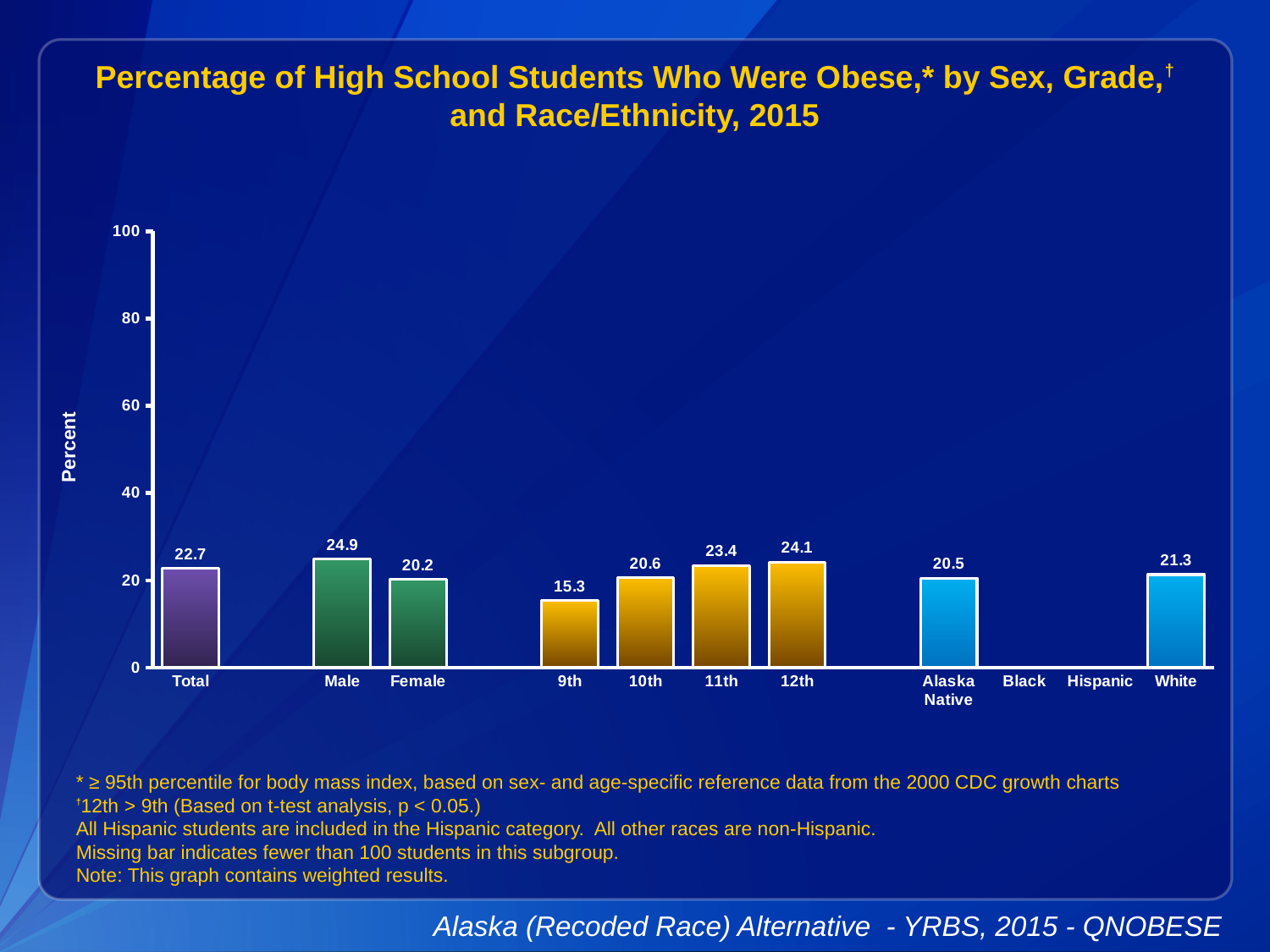
What is the difference between the values for 12th and 9th grade? 8.8 Which category has the lowest value among the bars shown? 9th What is the value for Total? 22.7 What is the value for Male? 24.9 Which is larger, the value for 11th grade or the value for 10th grade? 11th Which race/ethnicity categories have no bar shown? Black and Hispanic What is the value for Alaska Native? 20.5 What kind of chart is shown on the slide? bar chart What is the value for 9th grade? 15.3 Is the value for White greater or less than 40? less Which category has the highest value? Male What is the difference between the values for Male and Female? 4.7